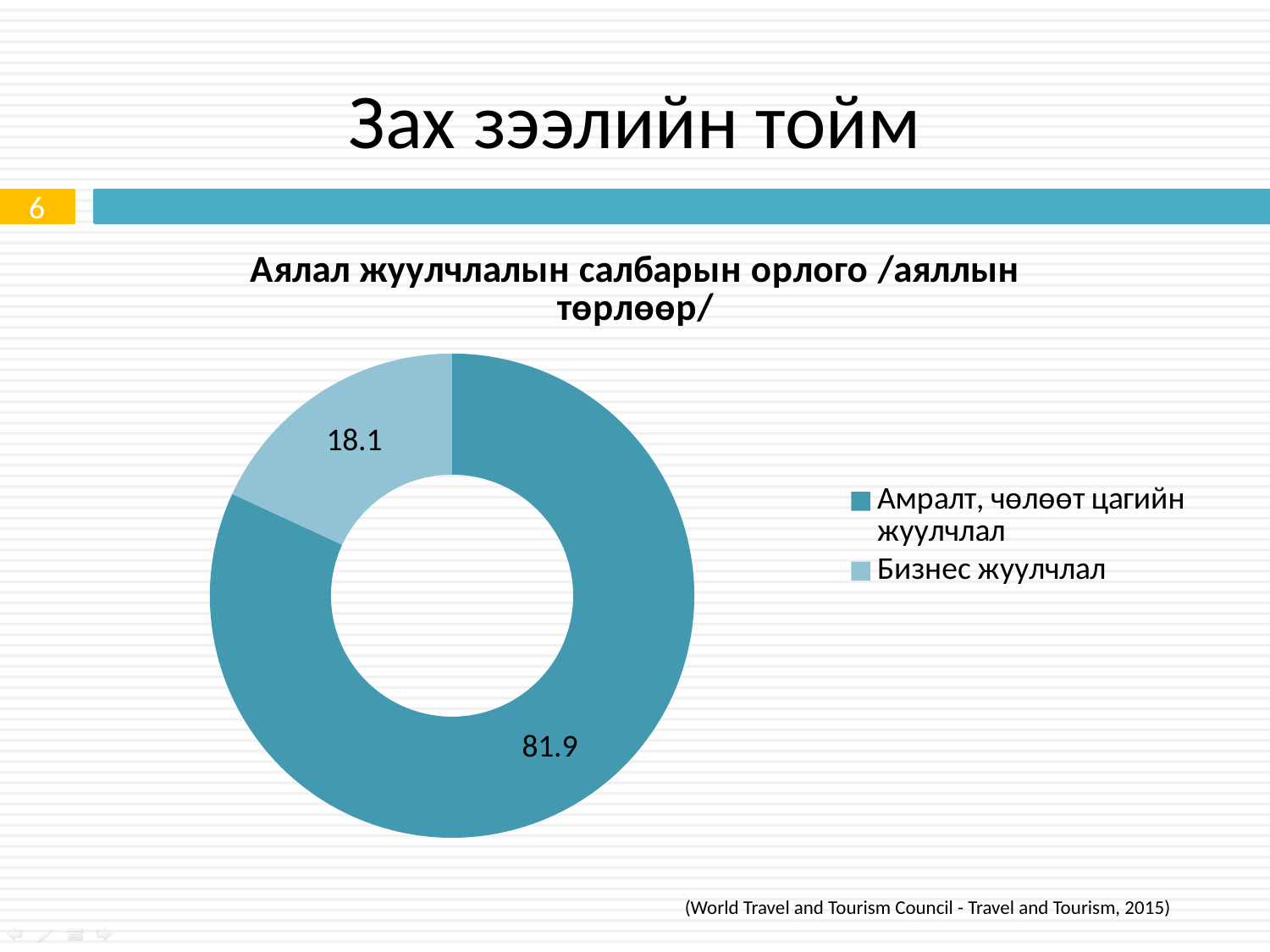
What is the total of the two values shown in the chart? 100 How many categories are shown in the chart? 2 Which is larger, the value for Амралт, чөлөөт цагийн жуулчлал or the value for Бизнес жуулчлал? Амралт, чөлөөт цагийн жуулчлал How many entries does the legend list? 2 What is the value for Амралт, чөлөөт цагийн жуулчлал? 81.9 What kind of chart is shown on the slide? Doughnut chart Which legend entry is shown in the lighter blue colour? Бизнес жуулчлал What is the difference between the values for Амралт, чөлөөт цагийн жуулчлал and Бизнес жуулчлал? 63.8 Which category has the largest share of the chart? Амралт, чөлөөт цагийн жуулчлал What is the value for Бизнес жуулчлал? 18.1 Which category has the smallest share of the chart? Бизнес жуулчлал What is the title of the chart? Аялал жуулчлалын салбарын орлого /аяллын төрлөөр/